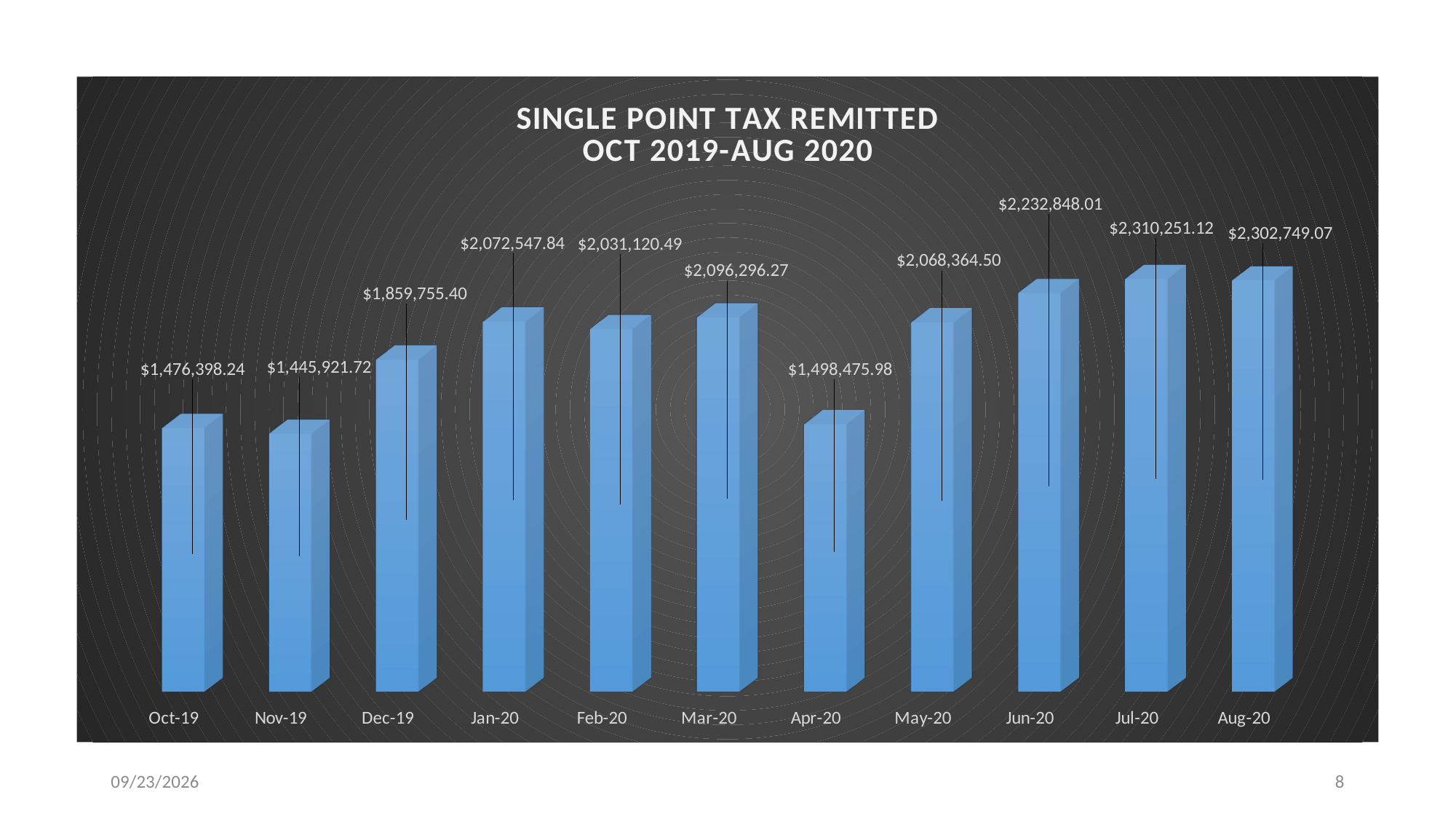
Which month has the highest value? Jul-20 What is the value for Jun-20? $2,232,848.01 What is the difference between the values for Jul-20 and Aug-20? $7,502.05 What kind of chart is shown on the slide? Bar chart What is the title of the chart? SINGLE POINT TAX REMITTED OCT 2019-AUG 2020 Which is larger, the value for Mar-20 or Feb-20? Mar-20 What is the difference between the values for Jan-20 and Dec-19? $212,792.44 Which is larger, the value for Oct-19 or Nov-19? Oct-19 What is the value for Apr-20? $1,498,475.98 Which month has the lowest value? Nov-19 What is the value for Jan-20? $2,072,547.84 How many months are shown on the chart? 11